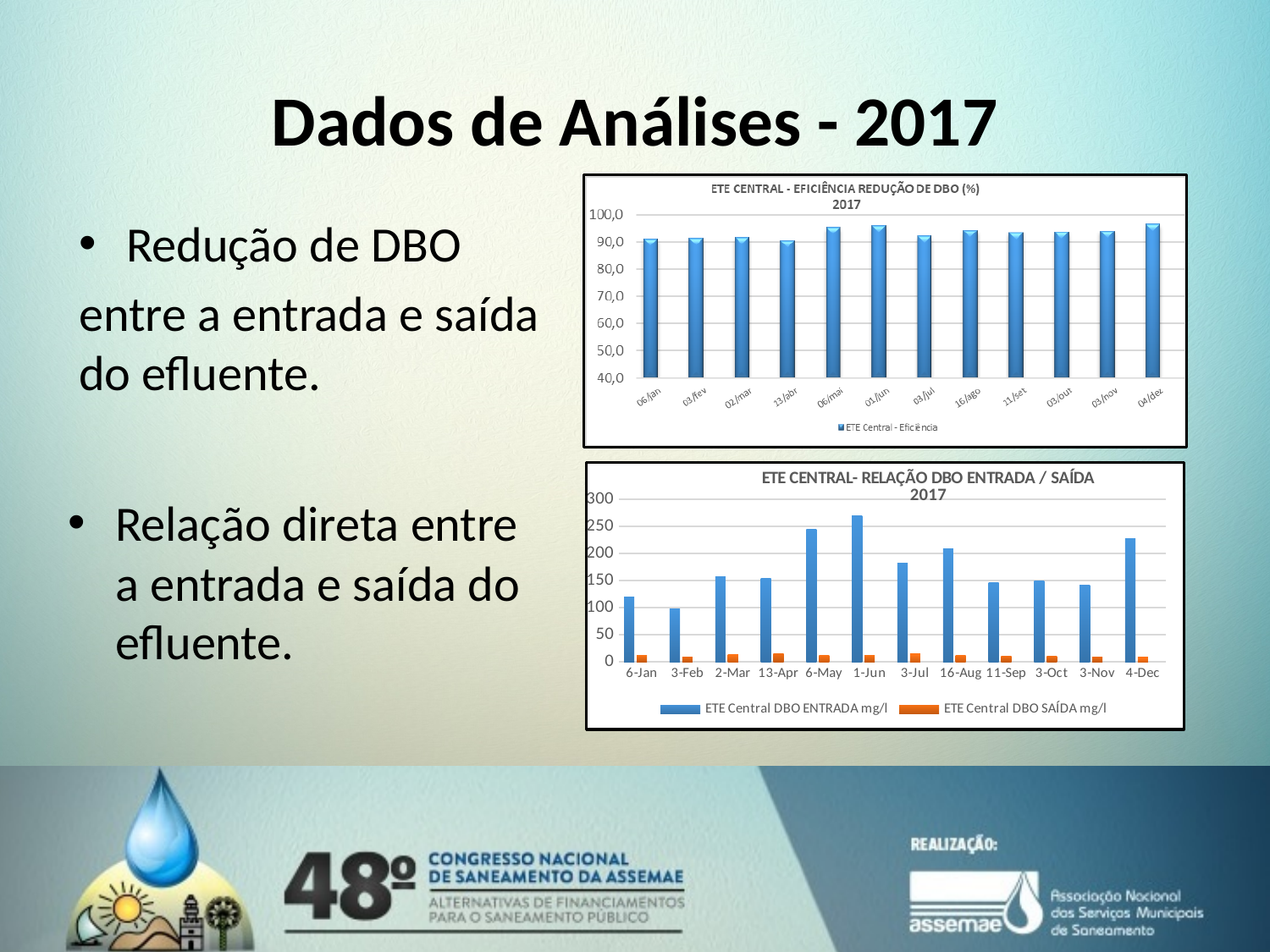
In the top chart 'ETE CENTRAL - EFICIÊNCIA REDUÇÃO DE DBO (%)', is the value for 13/abr greater or less than 80? greater How many series does the legend of the bottom chart 'ETE CENTRAL- RELAÇÃO DBO ENTRADA / SAÍDA' list? 2 In the bottom chart 'ETE CENTRAL- RELAÇÃO DBO ENTRADA / SAÍDA', which date has the highest ETE Central DBO ENTRADA mg/l value? 1-Jun In the bottom chart 'ETE CENTRAL- RELAÇÃO DBO ENTRADA / SAÍDA', is the ETE Central DBO ENTRADA mg/l value for 1-Jun greater or less than 250? greater How many dates are shown on the x axis of the bottom chart 'ETE CENTRAL- RELAÇÃO DBO ENTRADA / SAÍDA'? 12 In the top chart 'ETE CENTRAL - EFICIÊNCIA REDUÇÃO DE DBO (%)', is the value for 06/mai greater or less than 90? greater How many bars (dates) are plotted in the top chart 'ETE CENTRAL - EFICIÊNCIA REDUÇÃO DE DBO (%)'? 12 What kind of chart is the top chart titled 'ETE CENTRAL - EFICIÊNCIA REDUÇÃO DE DBO (%)'? bar chart In the bottom chart 'ETE CENTRAL- RELAÇÃO DBO ENTRADA / SAÍDA', which is larger for ETE Central DBO ENTRADA mg/l: 6-May or 3-Jul? 6-May In the bottom chart 'ETE CENTRAL- RELAÇÃO DBO ENTRADA / SAÍDA', what colour are the ETE Central DBO SAÍDA mg/l bars? orange In the bottom chart 'ETE CENTRAL- RELAÇÃO DBO ENTRADA / SAÍDA', which date has the lowest ETE Central DBO ENTRADA mg/l value? 3-Feb